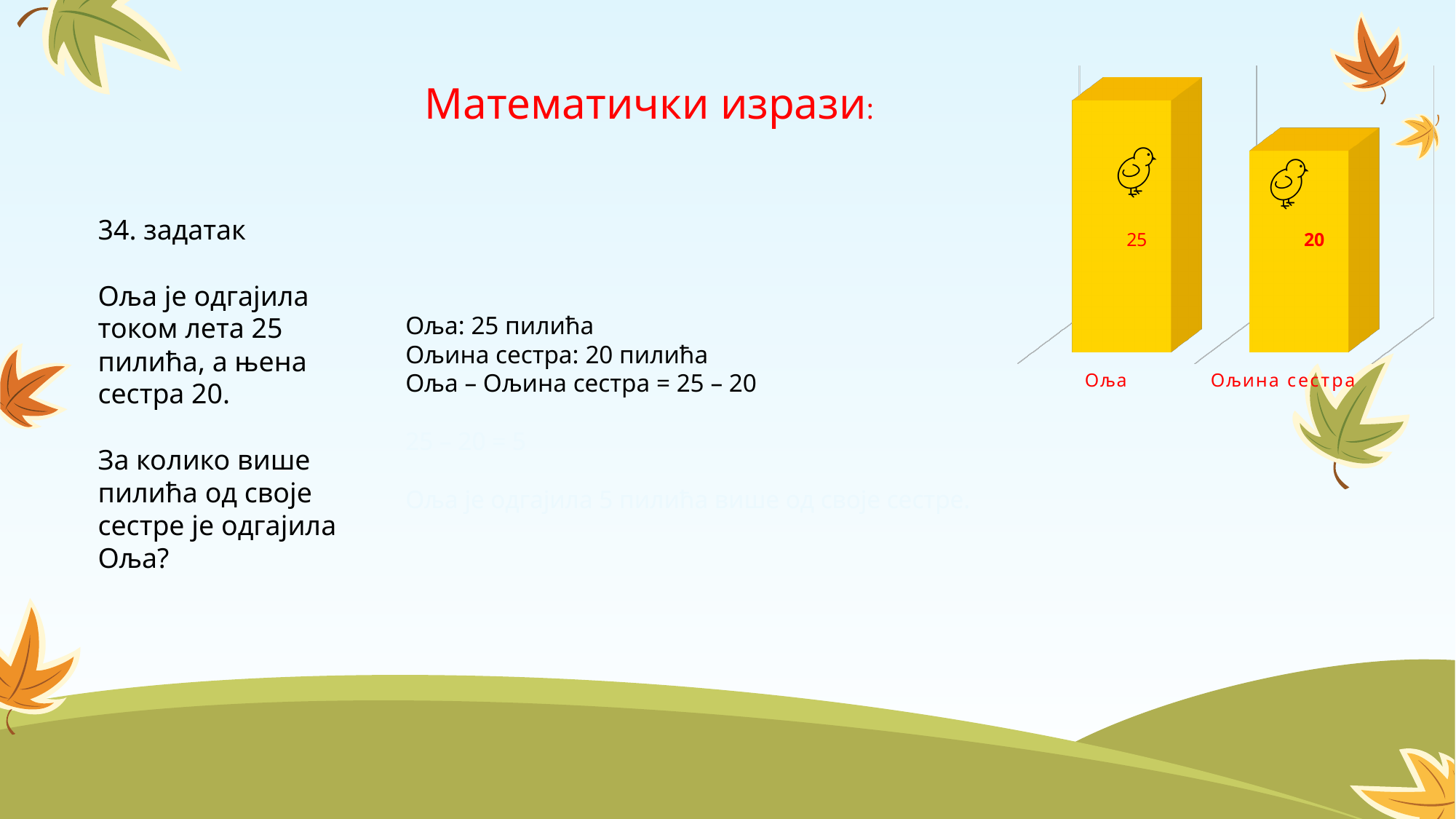
What is the value for Ољина сестра in the chart? 20 What is the value for Оља in the chart? 25 What is the label of the first bar in the chart? Оља What kind of chart is shown on the slide? bar chart Which is larger, the value for Оља or the value for Ољина сестра? Оља Which category has the highest value in the chart? Оља What colour are the bars in the chart? yellow What is the difference between the values for Оља and Ољина сестра? 5 Which category has the lowest value in the chart? Ољина сестра What is the total of the two bars in the chart? 45 How many categories are shown in the chart? 2